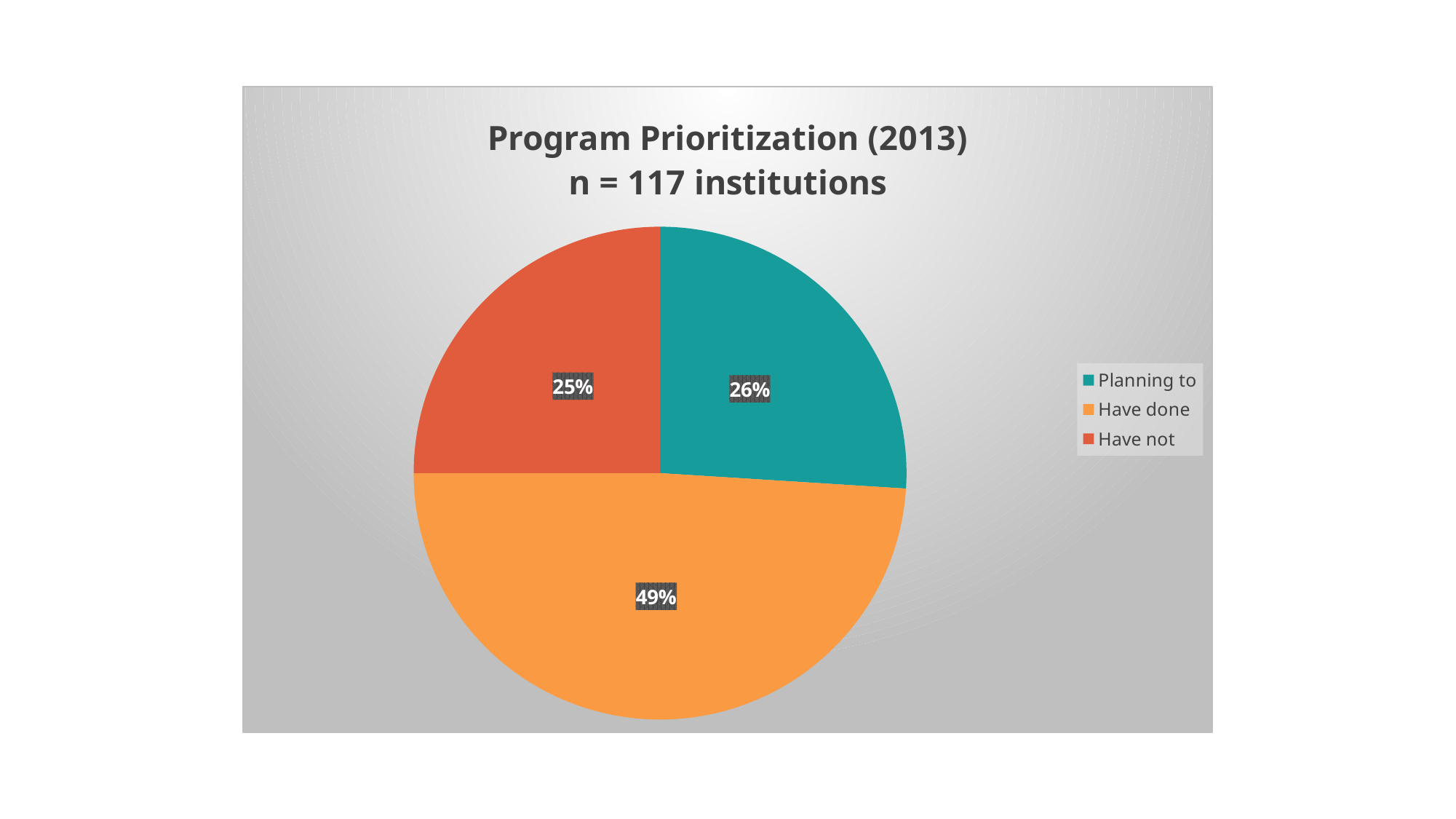
Which is larger, the share for 'Have done' or the share for 'Have not'? Have done Which category has the smallest share of the pie? Have not What share of institutions are in the 'Planning to' category? 26% What is the difference in percentage points between 'Planning to' and 'Have not'? 1 What is the title of the chart? Program Prioritization (2013) n = 117 institutions What share of institutions are in the 'Have done' category? 49% What share of institutions are in the 'Have not' category? 25% Which category has the largest share of the pie? Have done Which colour represents the 'Have not' category in the legend? red-orange What is the difference in percentage points between 'Have done' and 'Planning to'? 23 How many categories does the pie chart have? 3 What kind of chart is shown on the slide? pie chart